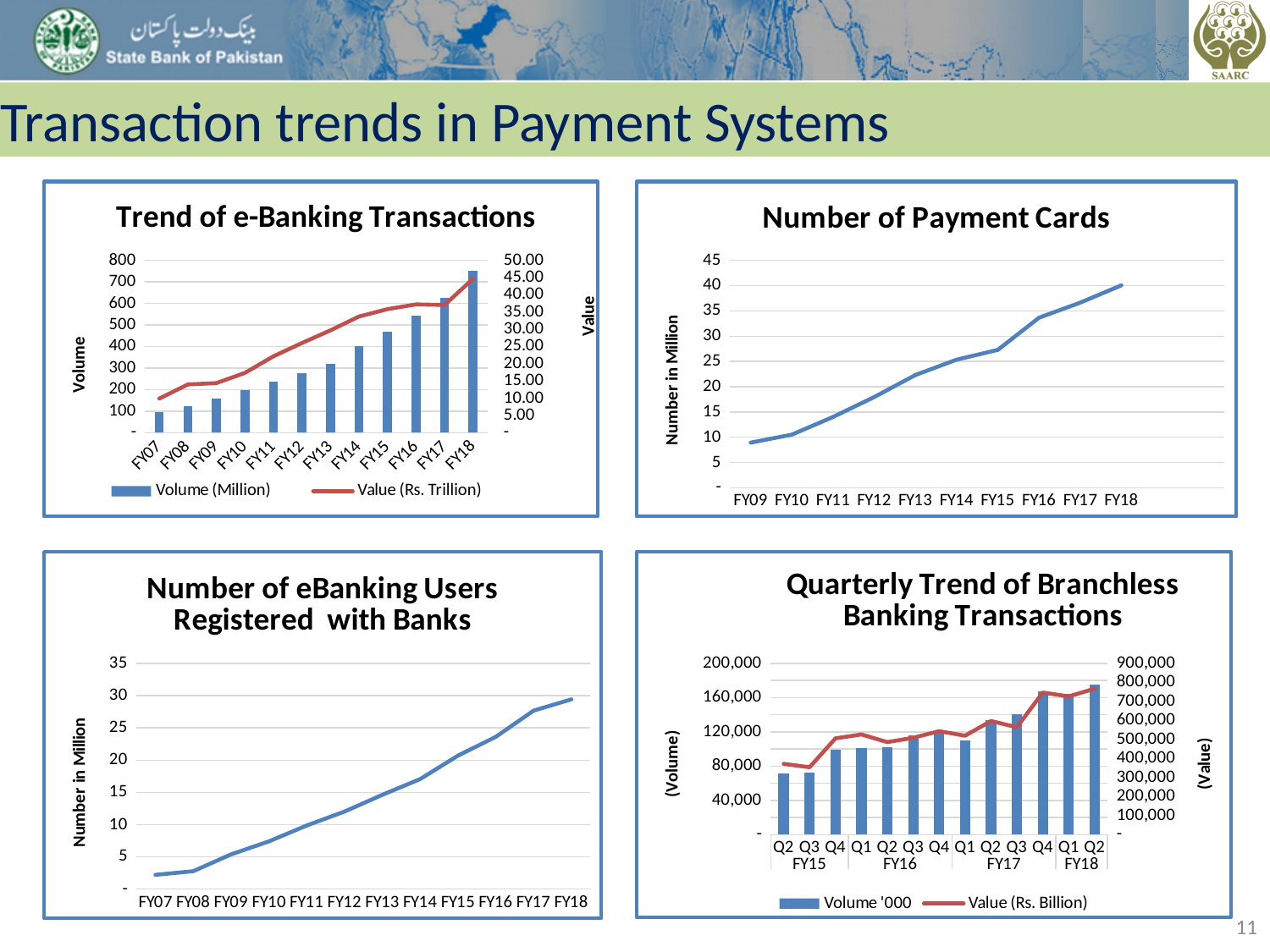
In the "Number of Payment Cards" chart, is the value for FY18 greater or less than 35? greater How many series does the legend of the "Trend of e-Banking Transactions" chart list? 2 In the "Trend of e-Banking Transactions" chart, which fiscal year has the highest volume bar? FY18 In the "Number of Payment Cards" chart, do the values rise or fall from FY09 to FY18? rise In the "Number of eBanking Users Registered with Banks" chart, is the value for FY07 greater or less than 5? less How many fiscal years are plotted on the x axis of the "Number of Payment Cards" chart? 10 How many fiscal years are plotted on the x axis of the "Number of eBanking Users Registered with Banks" chart? 12 In the "Quarterly Trend of Branchless Banking Transactions" chart, which quarter has the highest volume bar? Q2 FY18 In the "Trend of e-Banking Transactions" chart, which fiscal year has the lowest volume bar? FY07 What kind of chart is the "Number of Payment Cards" chart? line chart In the "Trend of e-Banking Transactions" chart, is the volume for FY18 greater or less than 600? greater What are the two legend entries of the "Quarterly Trend of Branchless Banking Transactions" chart? Volume '000 and Value (Rs. Billion)